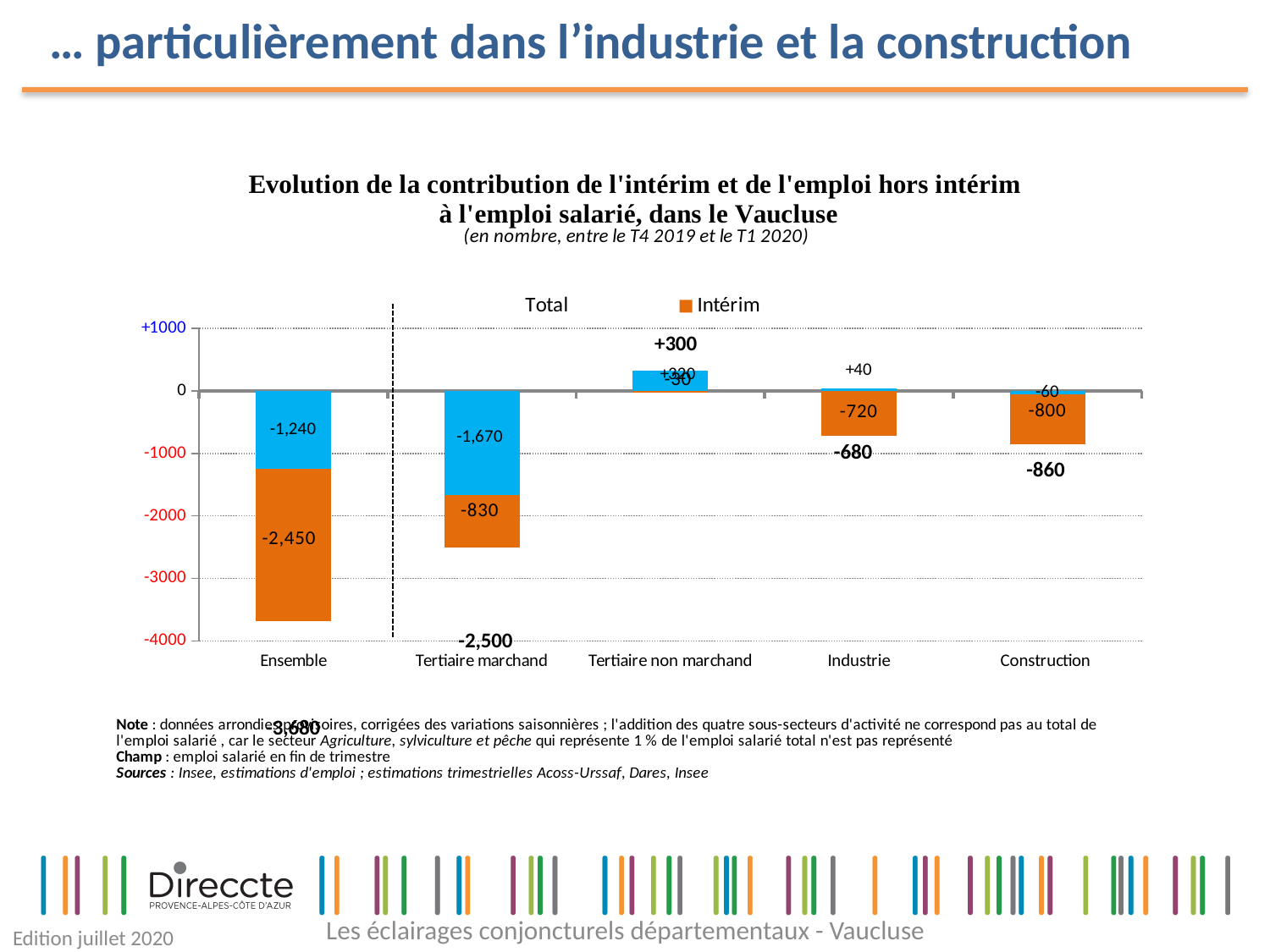
What is the total value shown for Tertiaire non marchand? +300 What is the total value shown for Tertiaire marchand? -2,500 What is the Intérim value for Construction? -800 What is the total value shown for Ensemble? -3,680 What is the difference between the total for Industrie (-680) and the total for Construction (-860)? 180 What is the Intérim value for Industrie? -720 Which sector has the only positive total? Tertiaire non marchand How many sector categories are shown on the x axis of the chart? 5 Which is larger in absolute terms, the Intérim value for Industrie or for Construction? Construction What is the Intérim value for Ensemble? -2,450 What is the Intérim value for Tertiaire marchand? -830 What type of chart is shown on the slide? bar chart